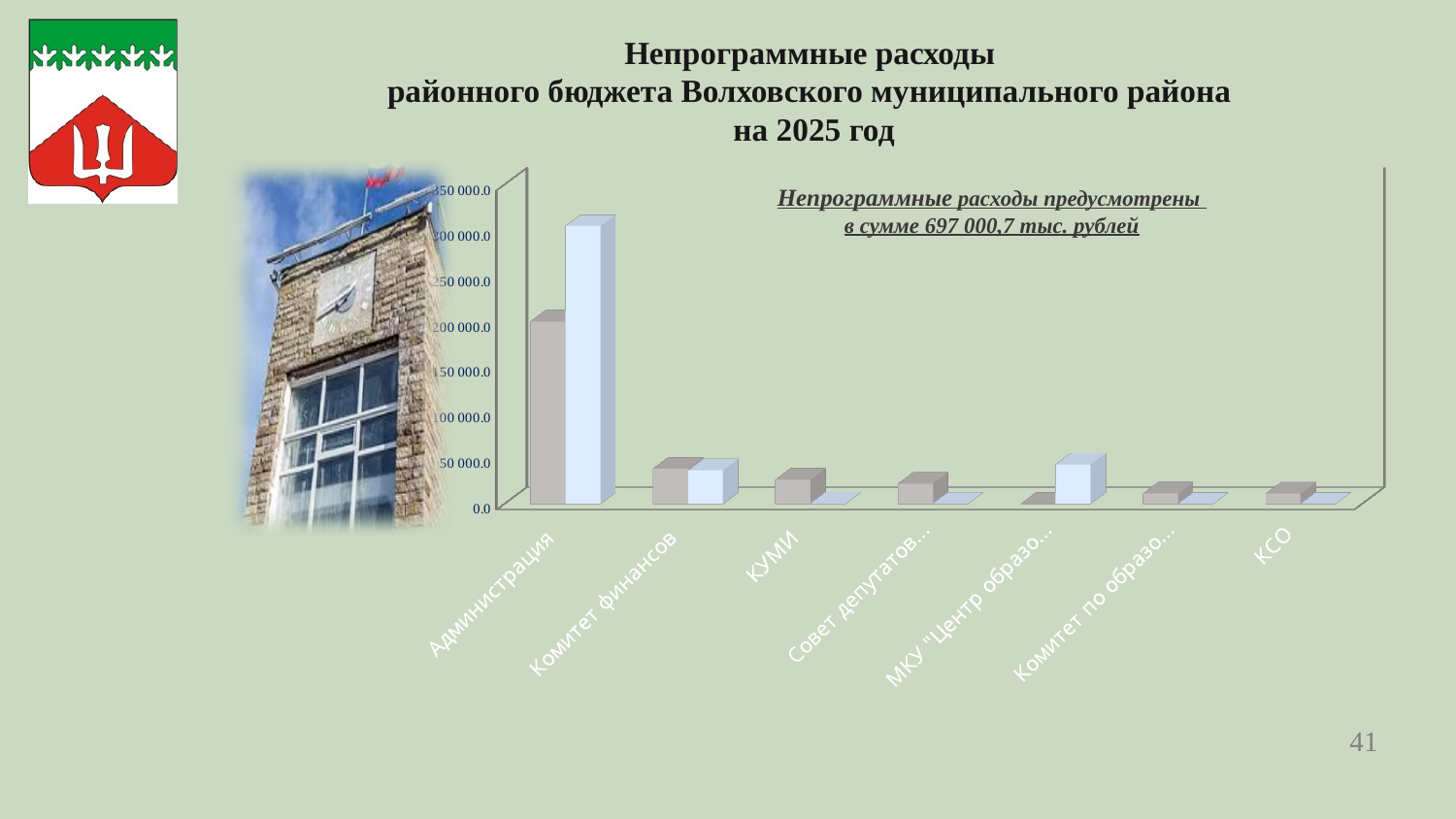
Is the value of the grey bar for КУМИ greater or less than 50 000.0? less How many categories are shown on the x axis of the chart? 7 Is the value of the grey bar for Комитет финансов greater or less than 100 000.0? less What kind of chart is shown on the slide? Bar chart What is the highest tick value shown on the vertical axis of the chart? 350 000.0 Which category has larger bars, Администрация or Комитет финансов? Администрация According to the text on the chart, what total sum of non-programme expenditures is planned? 697 000,7 тыс. рублей Which category has the tallest bars in the chart? Администрация Is the value of the taller (light blue) bar for Администрация greater or less than 250 000.0? greater Which category has a larger grey bar, Комитет финансов or КСО? Комитет финансов